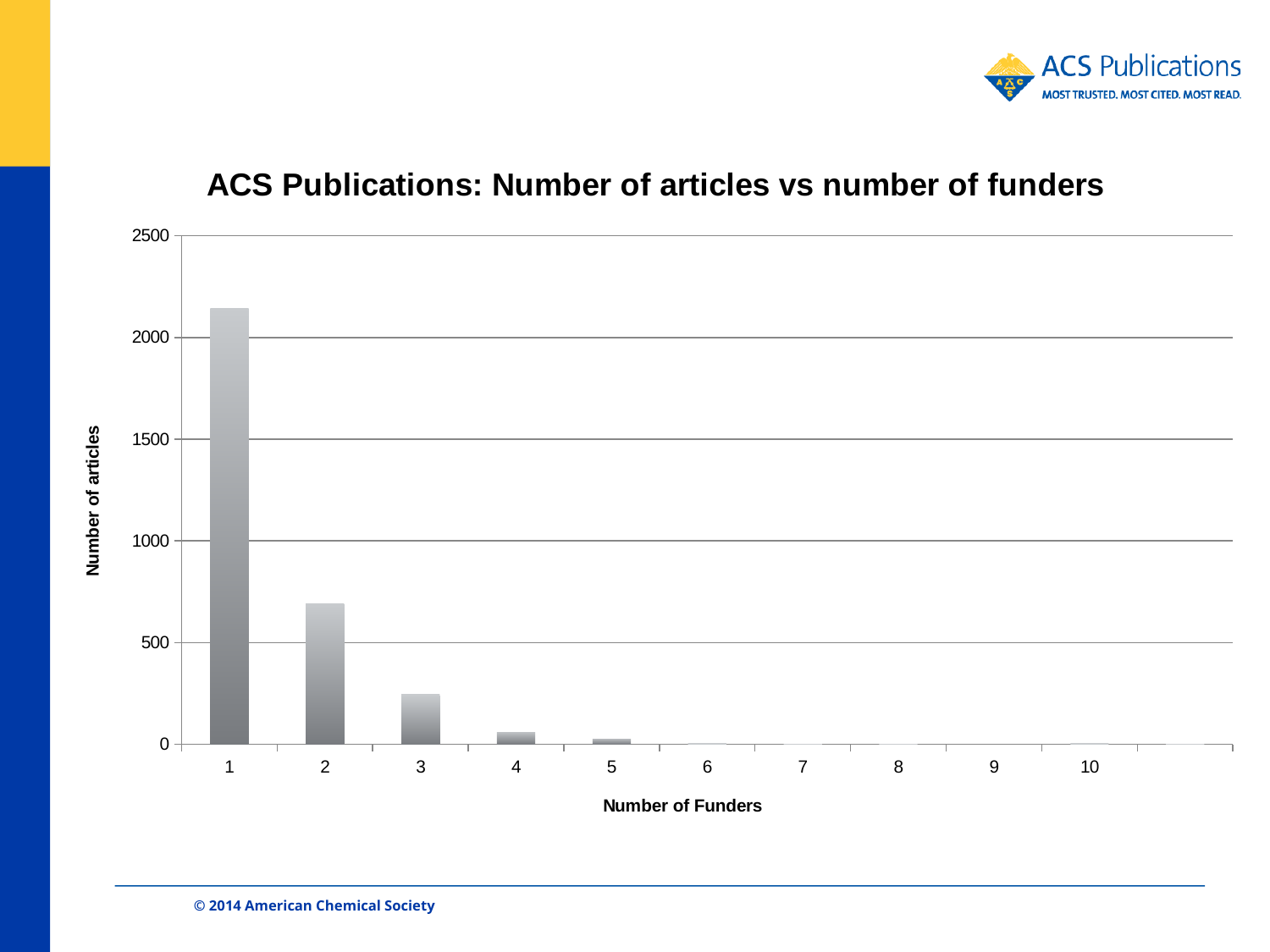
Which has more articles: 2 funders or 3 funders? 2 funders Which number of funders has the highest number of articles? 1 Is the number of articles for 1 funder greater or less than 2000? greater Is the number of articles for 3 funders greater or less than 500? less Which has more articles: 4 funders or 1 funder? 1 funder Is the number of articles for 2 funders greater or less than 500? greater How many number-of-funders categories are labelled on the x axis? 10 What kind of chart is shown on the slide? bar chart What is the label of the y axis? Number of articles Do the number of articles rise or fall as the number of funders increases? fall What is the title of the chart? ACS Publications: Number of articles vs number of funders